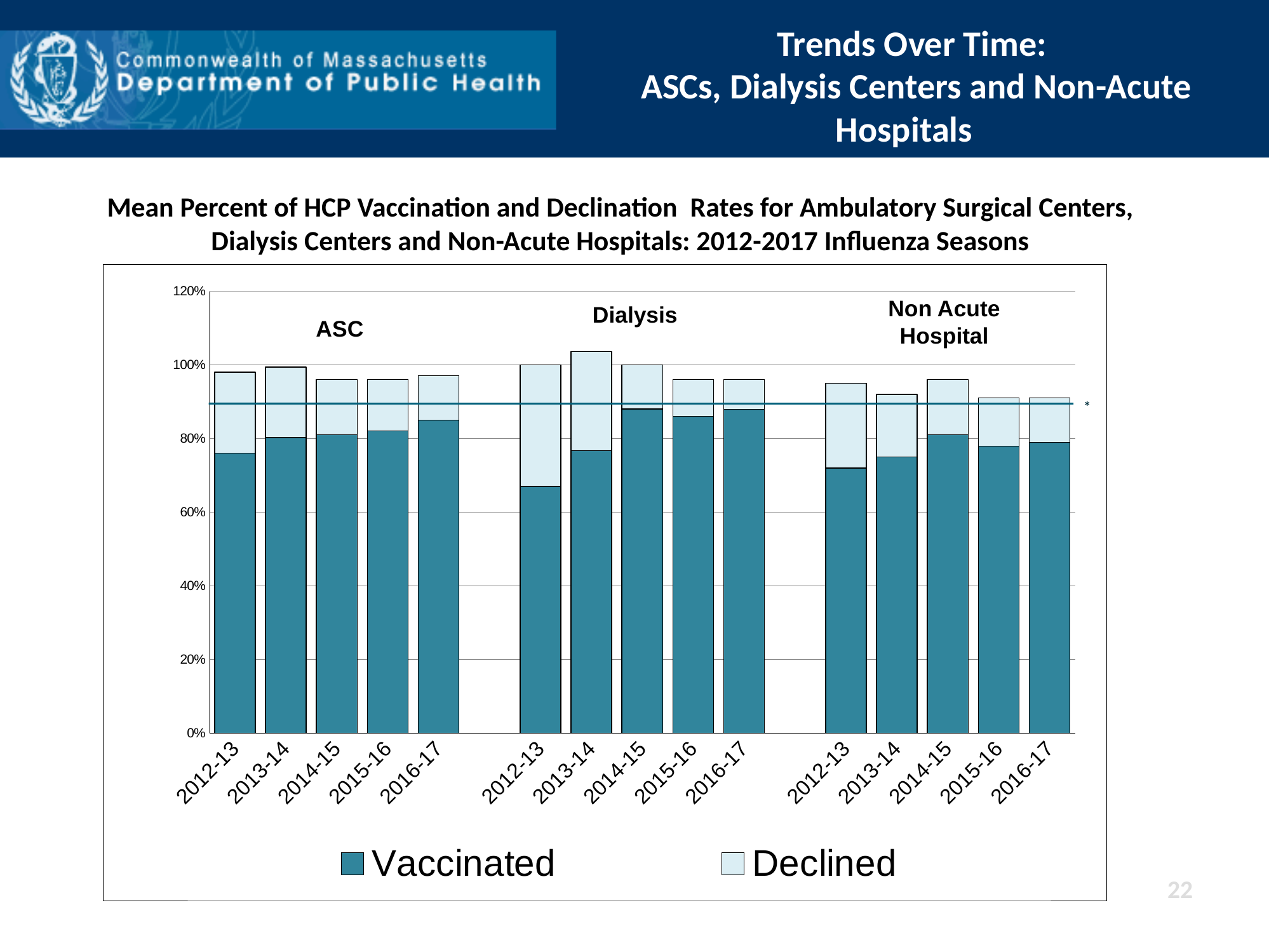
In the Dialysis group, which season has the lowest Vaccinated value? 2012-13 In the Dialysis group, which is larger: the Vaccinated value for 2012-13 or for 2013-14? 2013-14 Is the Vaccinated value for Dialysis in 2012-13 greater or less than 80%? less How many series does the legend list? 2 How many stacked bars are plotted in the chart? 15 What are the three facility groups labelled in the chart? ASC, Dialysis, Non Acute Hospital In the ASC group, do the Vaccinated values rise or fall from 2012-13 to 2016-17? rise What kind of chart is shown on the slide? bar chart What are the two series named in the legend? Vaccinated and Declined Is the Vaccinated value for Non Acute Hospital in 2012-13 greater or less than 80%? less Is the Vaccinated value for ASC in 2016-17 greater or less than 80%? greater